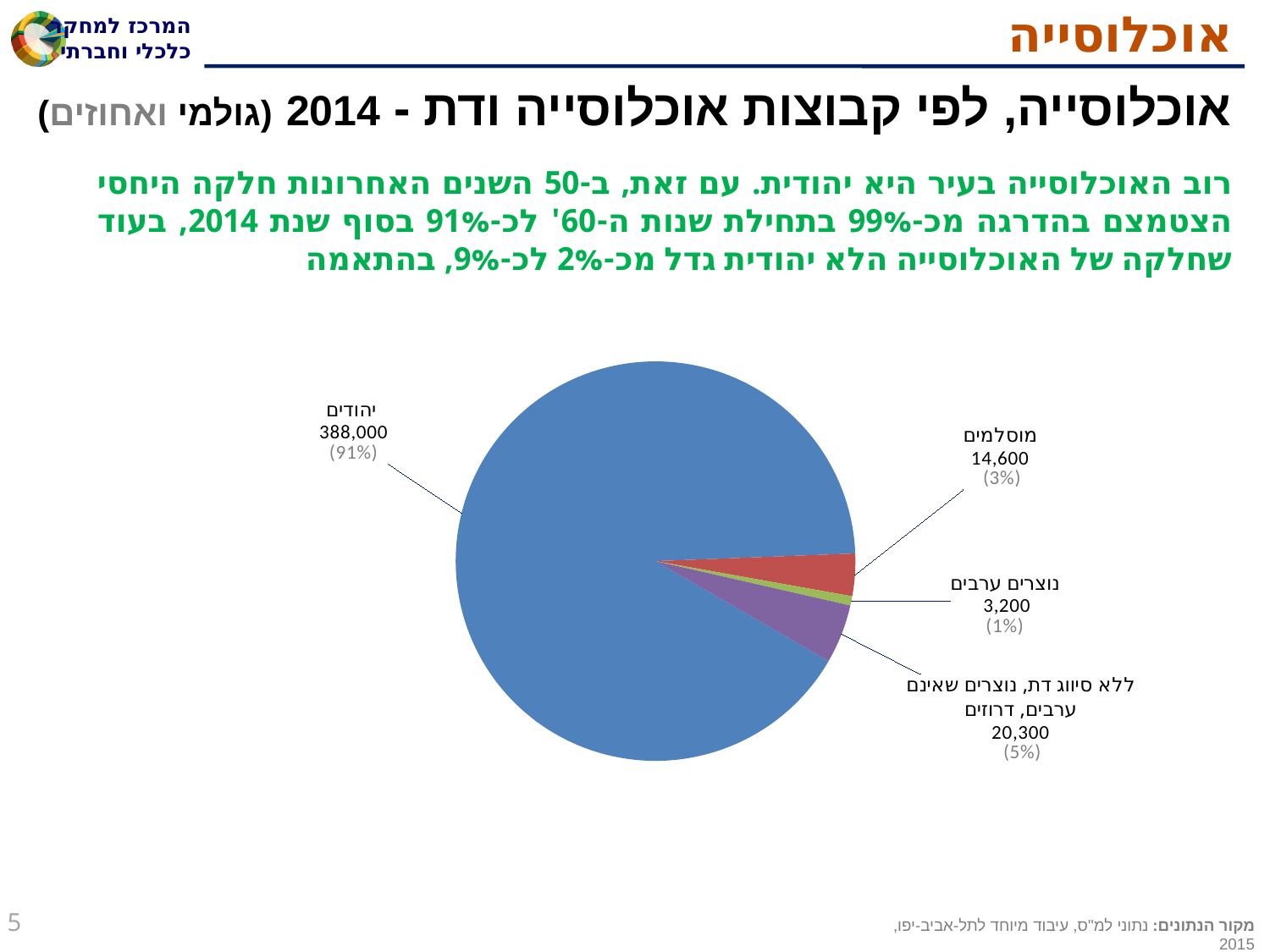
Which category has the smallest slice in the pie chart? נוצרים ערבים What is the difference between the values for מוסלמים and נוצרים ערבים? 11,400 What is the value shown for מוסלמים (Muslims) in the pie chart? 14,600 What share of the pie does the מוסלמים (Muslims) slice represent? 3% How many slices does the pie chart have? 4 Which is larger: the value for מוסלמים or the value for ללא סיווג דת, נוצרים שאינם ערבים, דרוזים? ללא סיווג דת, נוצרים שאינם ערבים, דרוזים What is the value shown for the slice labelled ללא סיווג דת, נוצרים שאינם ערבים, דרוזים? 20,300 Which category has the largest slice in the pie chart? יהודים What is the value shown for נוצרים ערבים (Arab Christians) in the pie chart? 3,200 What share of the pie does the יהודים (Jews) slice represent? 91% What kind of chart is shown on the slide? pie chart What is the value shown for יהודים (Jews) in the pie chart? 388,000